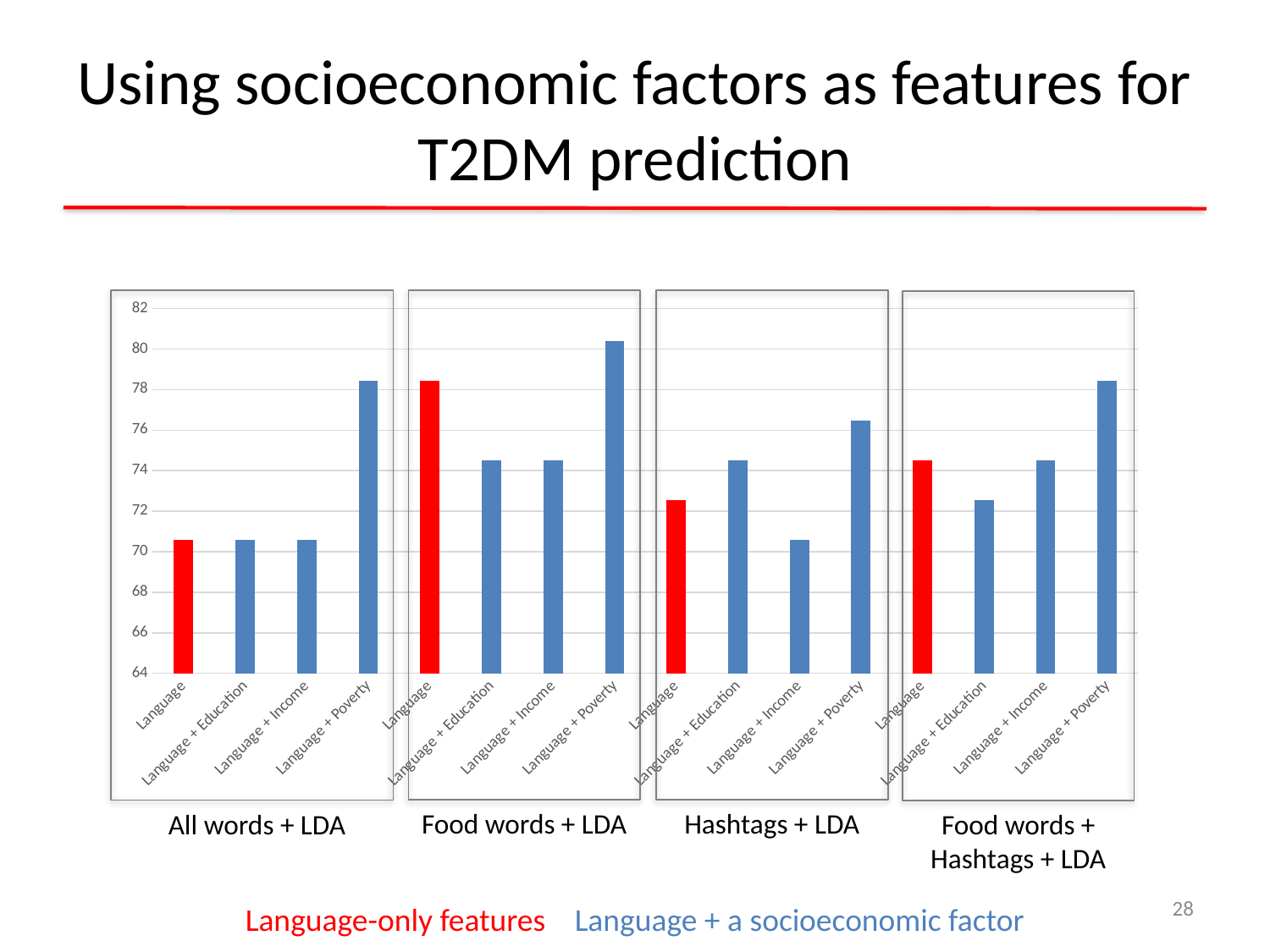
In the "All words + LDA" chart, is the value for Language + Poverty greater or less than 76? greater In the "Food words + LDA" chart, which category has the highest value? Language + Poverty What kind of chart is the "Hashtags + LDA" chart? bar chart In the "Food words + Hashtags + LDA" chart, is the value for Language + Education greater or less than 74? less How many charts are shown on the slide? 4 In the "Hashtags + LDA" chart, is the value for Language + Income greater or less than 72? less In the "All words + LDA" chart, which category has the highest value? Language + Poverty In the "Food words + LDA" chart, which is larger, the value for Language or the value for Language + Education? Language In the "Food words + Hashtags + LDA" chart, which category has the lowest value? Language + Education How many categories are shown in the "All words + LDA" chart? 4 In the "Hashtags + LDA" chart, which category has the lowest value? Language + Income In the "Hashtags + LDA" chart, which is larger, the value for Language + Education or the value for Language? Language + Education